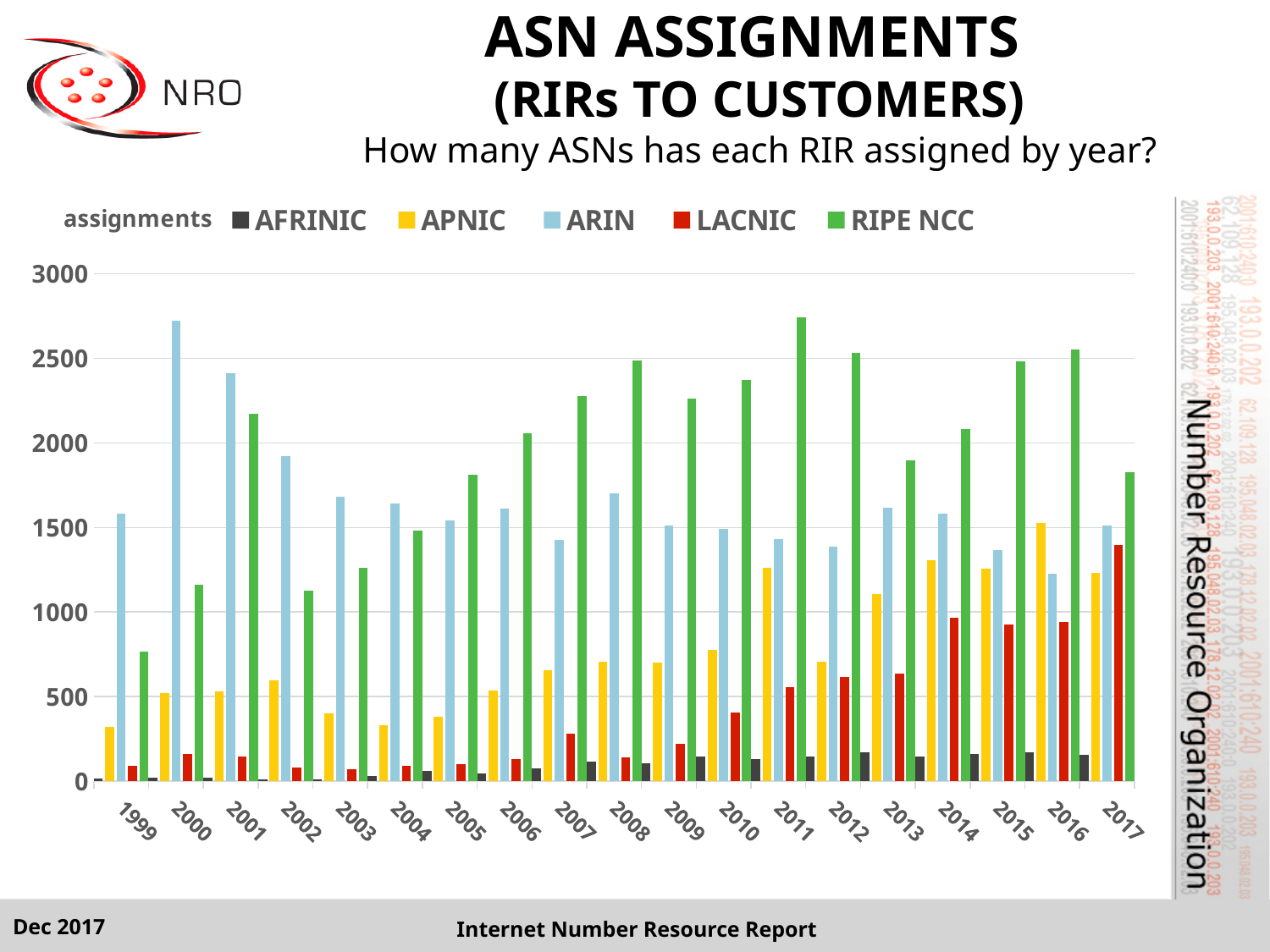
In which year is the ARIN bar the highest? 2000 Is the value for APNIC in 1999 greater or less than 500? less Is the value for ARIN in 2000 greater or less than 2500? greater Does the LACNIC series generally rise or fall from 1999 to 2017? rise Which RIR has the highest number of ASN assignments in 2017? RIPE NCC What kind of chart is shown on the slide? bar chart In which year is the RIPE NCC bar the lowest? 1999 Is the value for LACNIC in 2017 greater or less than 1000? greater Which is larger in 1999, the ARIN value or the RIPE NCC value? ARIN How many series does the legend list? 5 How many years are shown on the x axis? 19